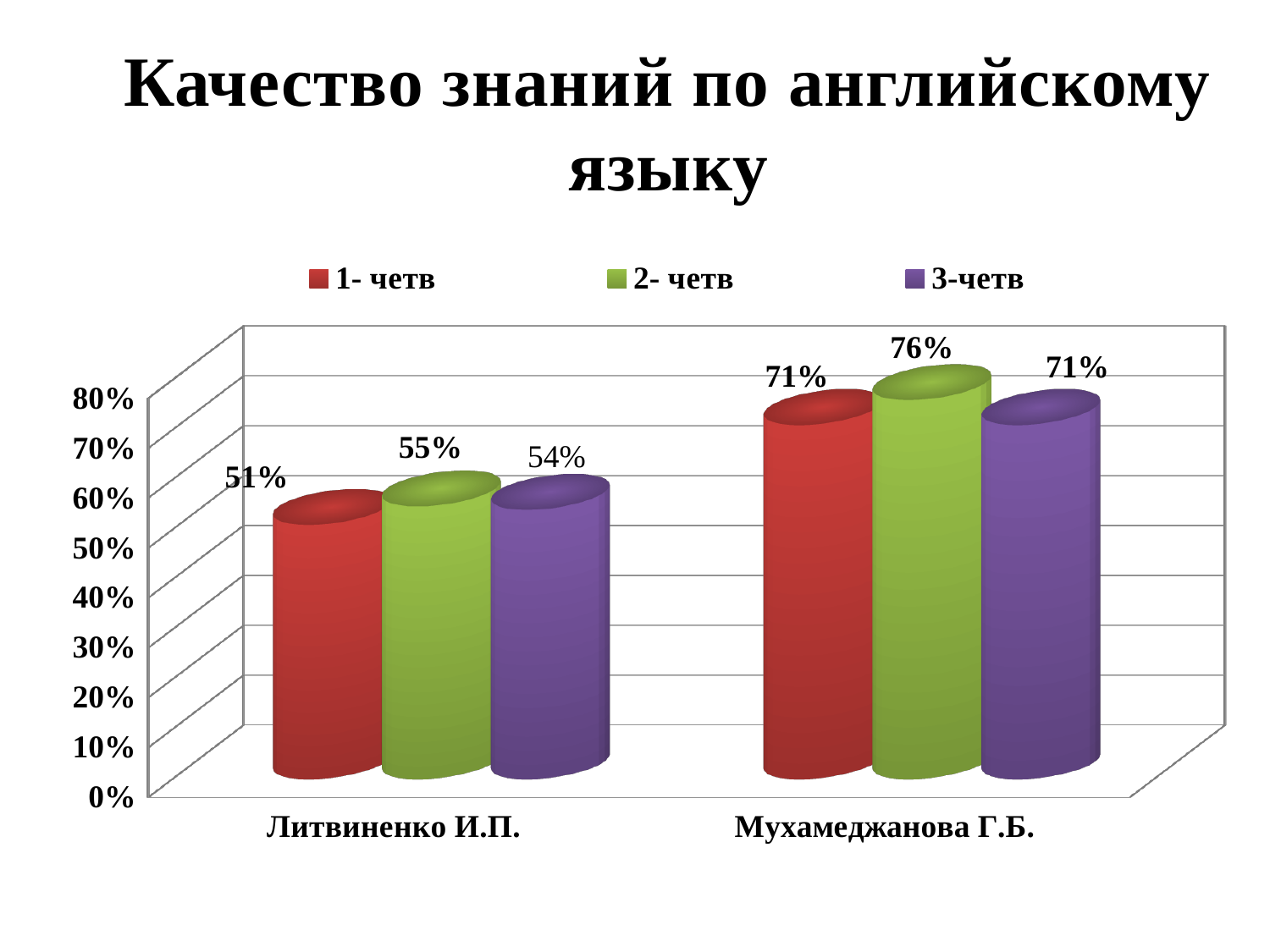
Which series has the lowest value for Литвиненко И.П.? 1- четв What kind of chart is shown on the slide? bar chart What is the title of the chart on the slide? Качество знаний по английскому языку What is the value for Литвиненко И.П. in the 3-четв series? 54% What is the value for Литвиненко И.П. in the 1- четв series? 51% Which is larger: the 3-четв value for Литвиненко И.П. or the 3-четв value for Мухамеджанова Г.Б.? Мухамеджанова Г.Б. Which teacher has the highest value in the 2- четв series? Мухамеджанова Г.Б. What is the difference between the 1- четв and 2- четв values for Литвиненко И.П.? 4% How many teachers (categories) are shown on the x axis? 2 How many series does the legend list? 3 What is the difference between the 2- четв values for Мухамеджанова Г.Б. and Литвиненко И.П.? 21% What is the value for Мухамеджанова Г.Б. in the 2- четв series? 76%